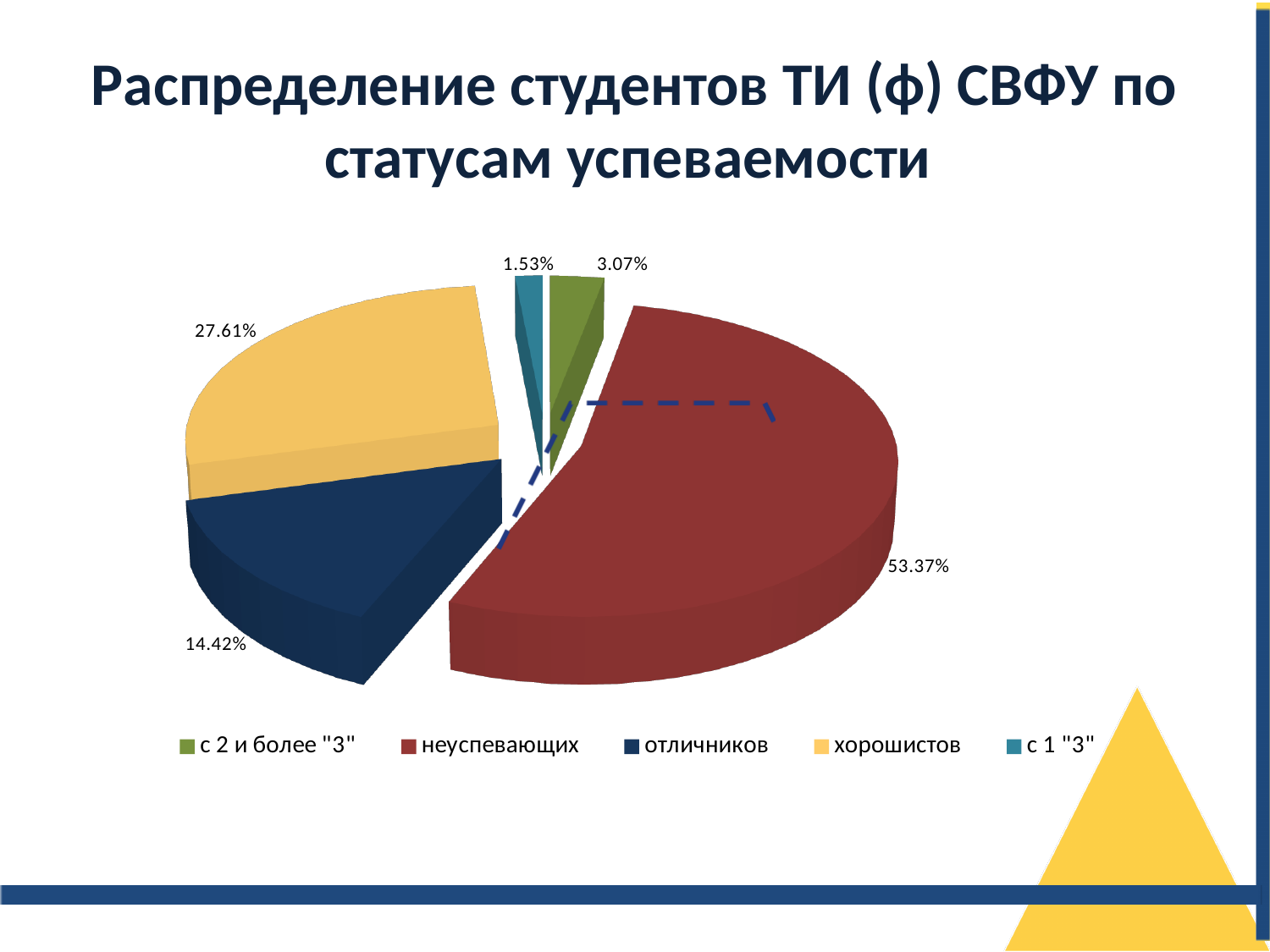
What share of students are неуспевающих? 53.37% Which is larger: the share of хорошистов or the share of отличников? хорошистов Which category has the smallest share of the pie? с 1 "3" What share of students are с 1 "3"? 1.53% What kind of chart is shown on the slide? pie chart What share of students are с 2 и более "3"? 3.07% What share of students are хорошистов? 27.61% How many categories does the pie chart show? 5 Which category has the largest share of the pie? неуспевающих What is the difference between the share of неуспевающих and the share of хорошистов? 25.76% What share of students are отличников? 14.42% What colour is the slice for неуспевающих? red